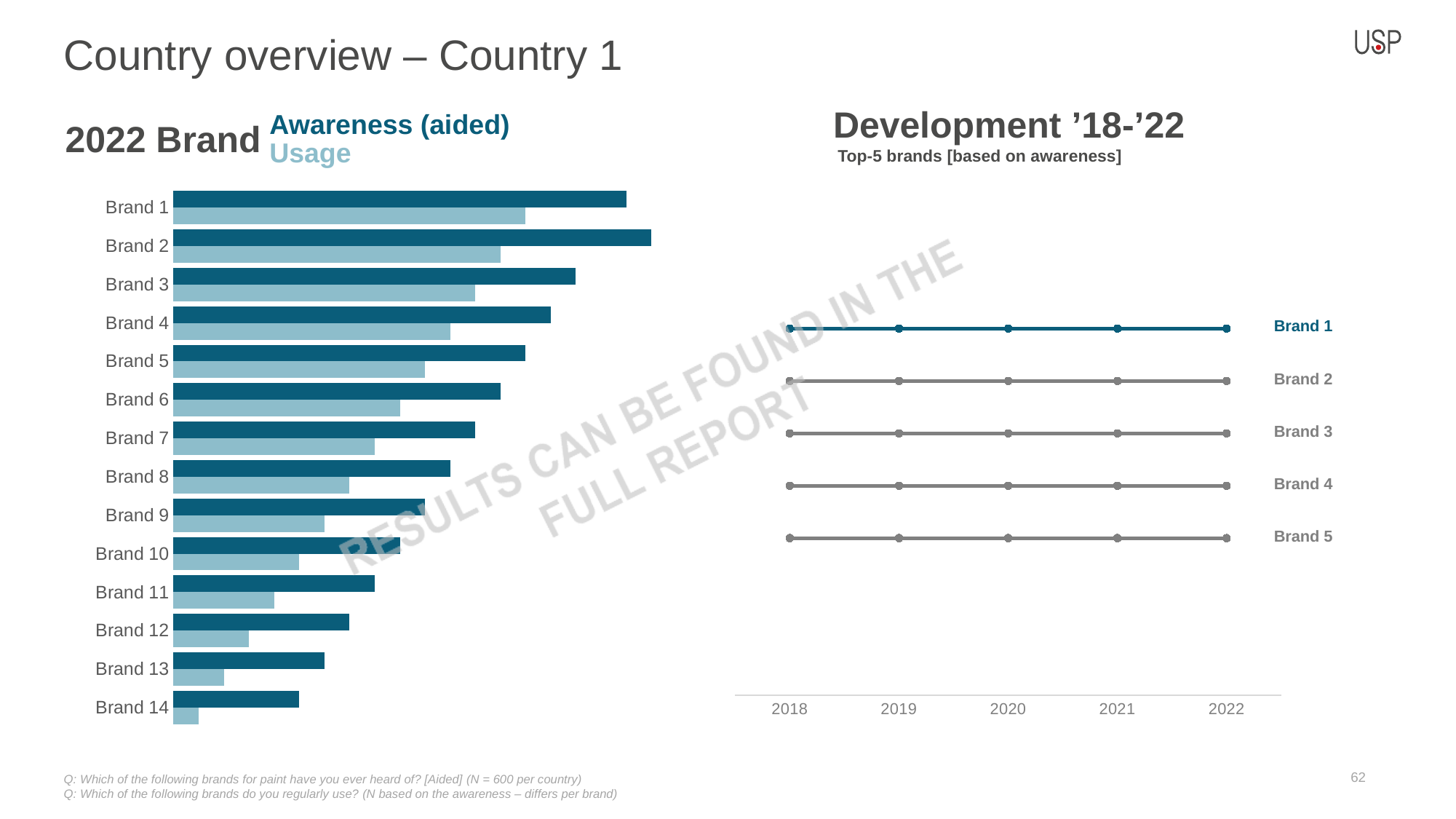
How many brands are shown in the 2022 Brand Awareness (aided) / Usage bar chart? 14 In the Development '18-'22 chart, does the line for Brand 1 rise, fall or stay flat from 2018 to 2022? Stays flat In the 2022 Brand Awareness (aided) / Usage chart, which brand has the lowest usage? Brand 14 How many years are shown on the x axis of the Development '18-'22 chart? 5 What kind of chart is the 2022 Brand Awareness (aided) / Usage chart on the left? Bar chart In the 2022 Brand Awareness (aided) / Usage chart, which is larger: the usage of Brand 1 or the usage of Brand 2? Brand 1 How many brands are plotted in the Development '18-'22 line chart? 5 What kind of chart is the Development '18-'22 chart on the right? Line chart How many series does the 2022 Brand Awareness (aided) / Usage bar chart show? 2 In the 2022 Brand Awareness (aided) / Usage chart, which is larger: the awareness (aided) of Brand 5 or the awareness (aided) of Brand 10? Brand 5 In the 2022 Brand Awareness (aided) / Usage chart, which brand has the highest awareness (aided)? Brand 2 In the 2022 Brand Awareness (aided) / Usage chart, which brand has the lowest awareness (aided)? Brand 14